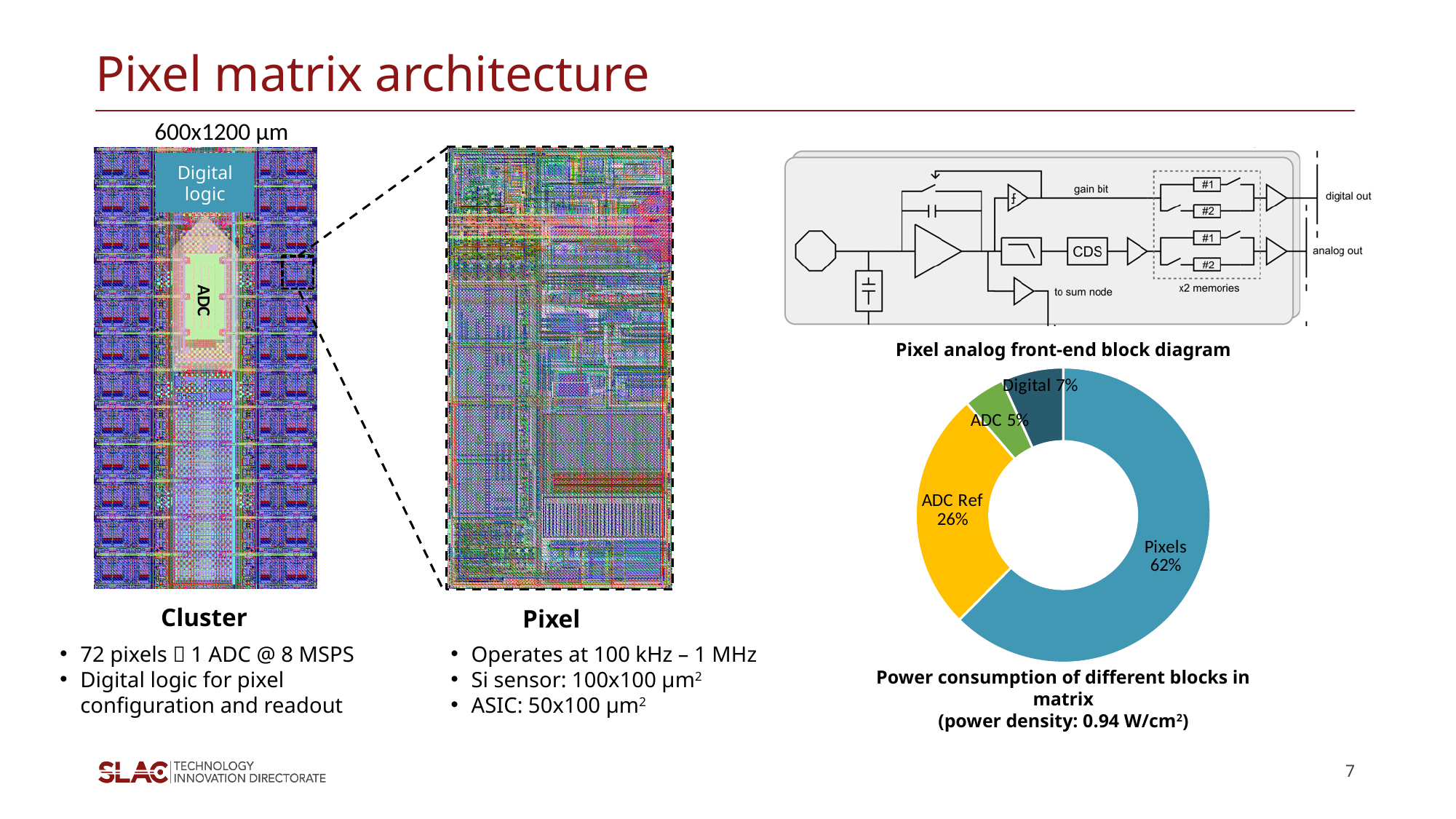
Which has a larger share of power consumption, Digital or ADC? Digital What percentage of power consumption is attributed to ADC Ref in the chart? 26% How many percentage points larger is the Pixels share than the ADC Ref share? 36 What is the share of the Digital block in the power consumption chart? 7% Which block consumes the smallest share of power according to the chart? ADC What kind of chart is used to show the power consumption of different blocks? doughnut chart What power density is stated in the title of the power consumption chart? 0.94 W/cm² What share of power consumption does the Pixels block account for in the doughnut chart? 62% What is the share of the ADC block in the power consumption chart? 5% How many blocks are shown in the power consumption chart? 4 What is the combined share of the ADC Ref and ADC blocks in the chart? 31% Which block consumes the largest share of power according to the chart? Pixels